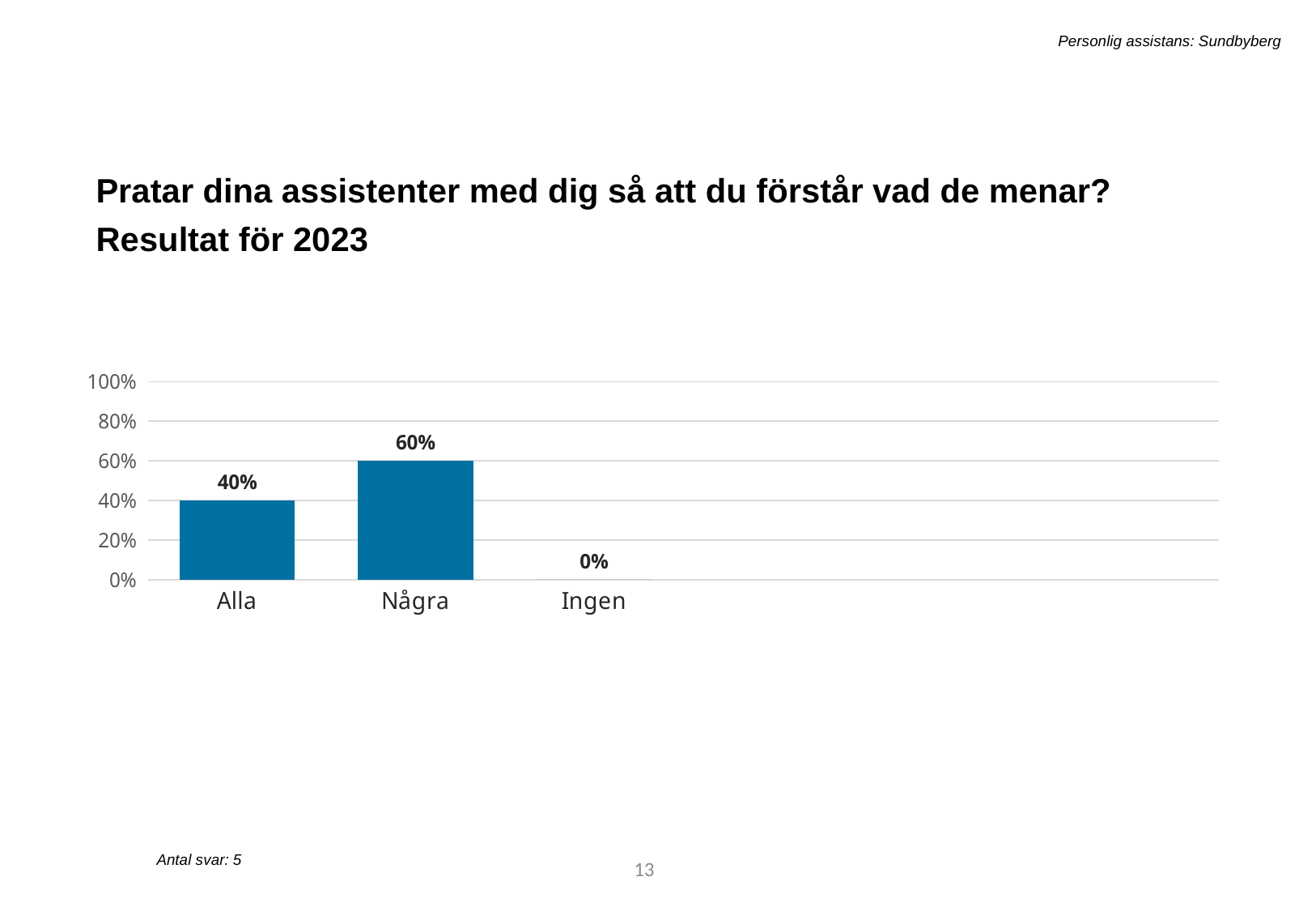
What kind of chart is shown on the slide? Bar chart Which category has the lowest value? Ingen How many categories are shown on the x axis? 3 What is the value for Alla? 40% Which category has the highest value? Några What is the value for Några? 60% What is the highest value shown on the y axis? 100% What is the value for Ingen? 0% Which is larger, the value for Alla or the value for Några? Några What is the total of the values for Alla and Några? 100% What is the difference between the values for Några and Alla? 20% Is the value for Alla greater or less than 20%? greater